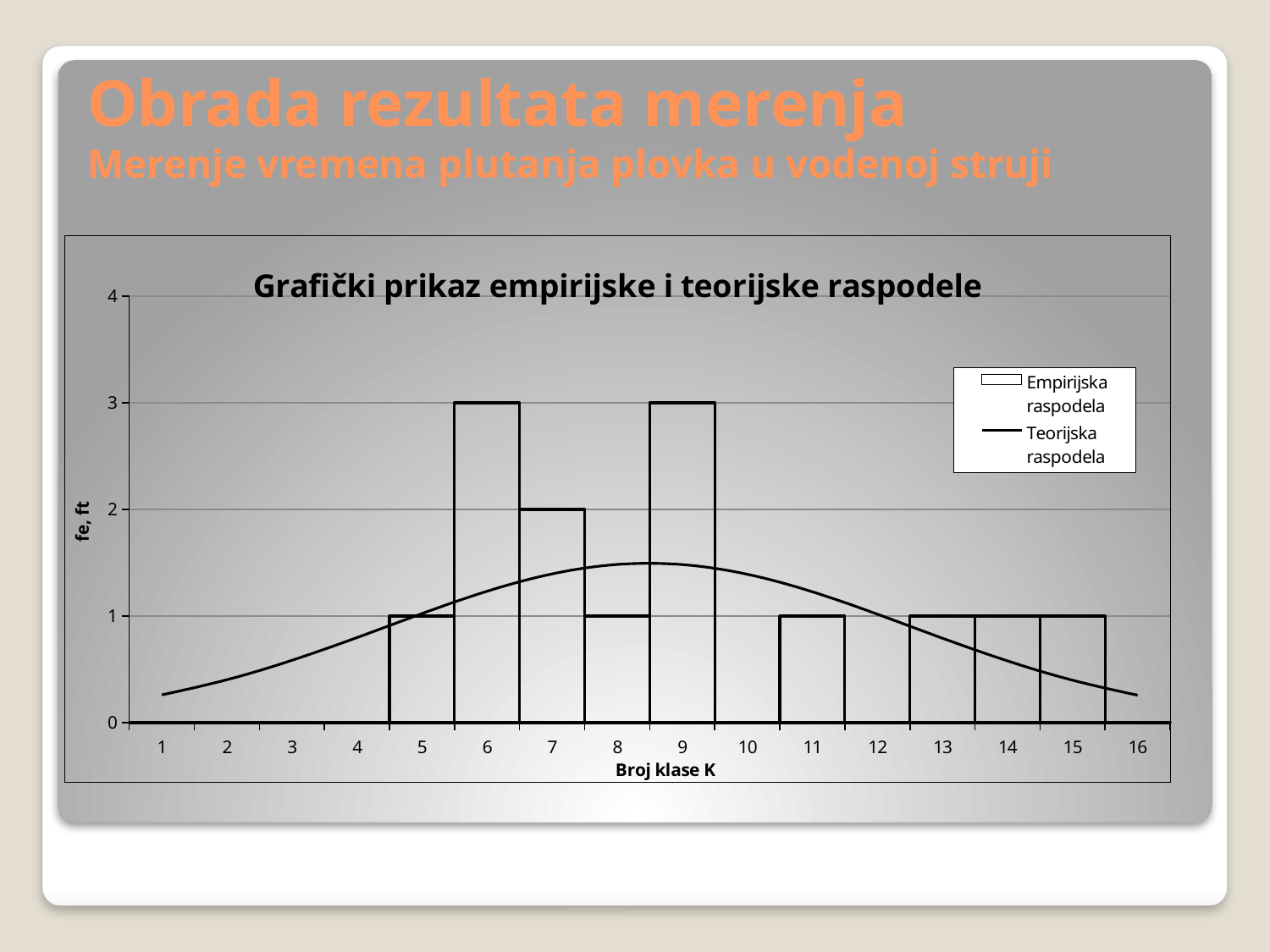
How many series does the legend list? 2 Which classes have the highest Empirijska raspodela value? 6 and 9 What is the Empirijska raspodela value for class 11? 1 What kind of chart is shown on the slide? bar and line chart What is the Empirijska raspodela value for class 7? 2 What is the title of the chart? Grafički prikaz empirijske i teorijske raspodele What is the Empirijska raspodela value for class 6? 3 What is the difference between the Empirijska raspodela values for class 6 and class 7? 1 Is the Teorijska raspodela value at class 1 greater or less than 1? less Is the Teorijska raspodela value at class 8 greater or less than 1? greater How many classes (Broj klase K) are shown on the x axis? 16 Which has the larger Empirijska raspodela value, class 7 or class 8? class 7